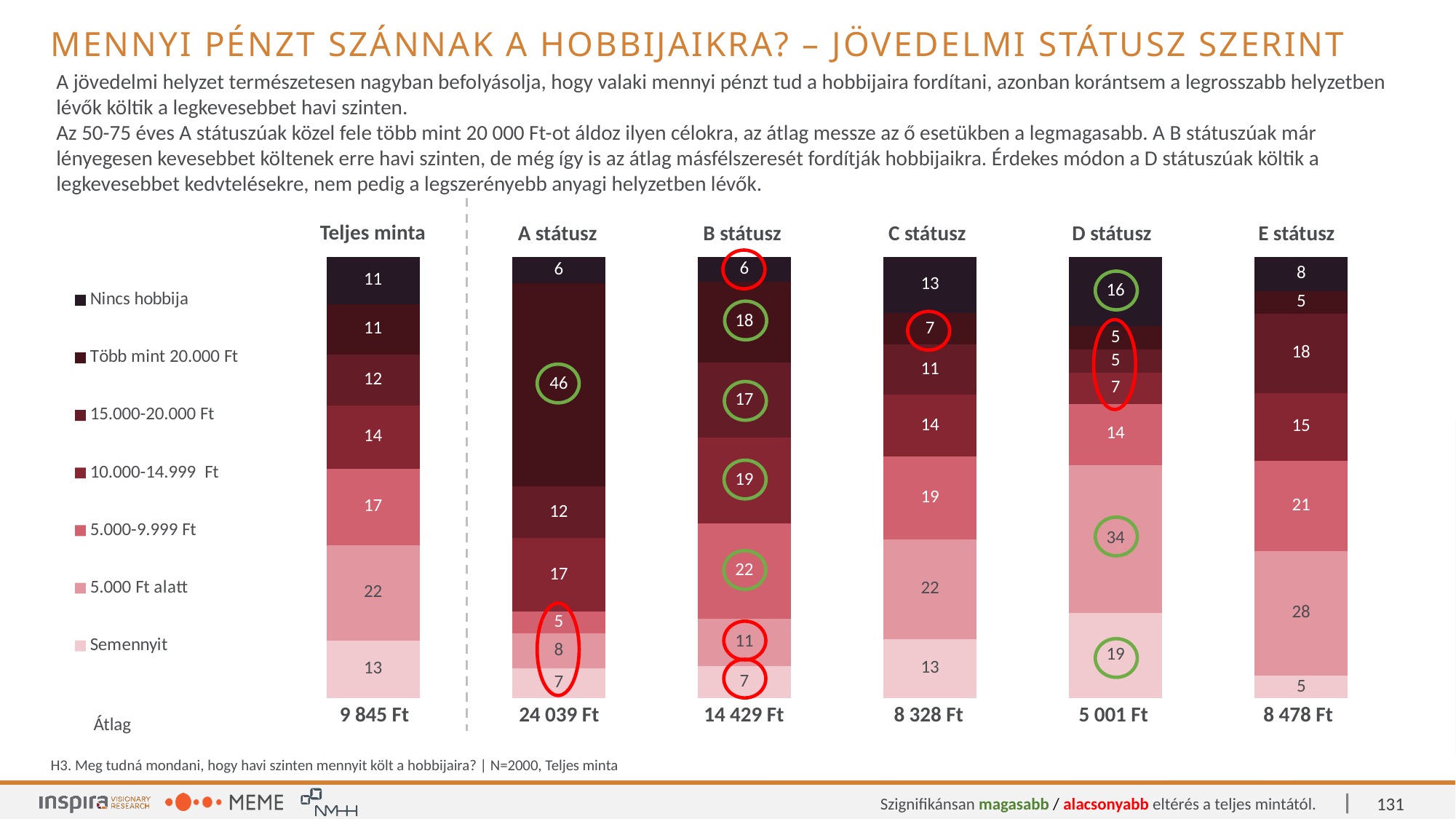
What is the average (Átlag) monthly hobby spending for the Teljes minta? 9 845 Ft Which group has the highest average (Átlag) monthly hobby spending? A státusz What percentage of the A státusz group spends more than 20,000 Ft (Több mint 20.000 Ft) on hobbies? 46 How many series does the legend list? 7 What kind of chart is shown on the slide? Stacked bar chart Which group has the lowest average (Átlag) monthly hobby spending? D státusz What is the total of the segments in the Teljes minta bar? 100 How many bars (groups) are shown in the chart? 6 What is the difference between the Több mint 20.000 Ft values of the A státusz and B státusz bars? 28 What is the average (Átlag) monthly hobby spending shown for the D státusz group? 5 001 Ft Which is larger: the Semennyit value for D státusz or for C státusz? D státusz What is the value of the 5.000 Ft alatt segment for the E státusz bar? 28